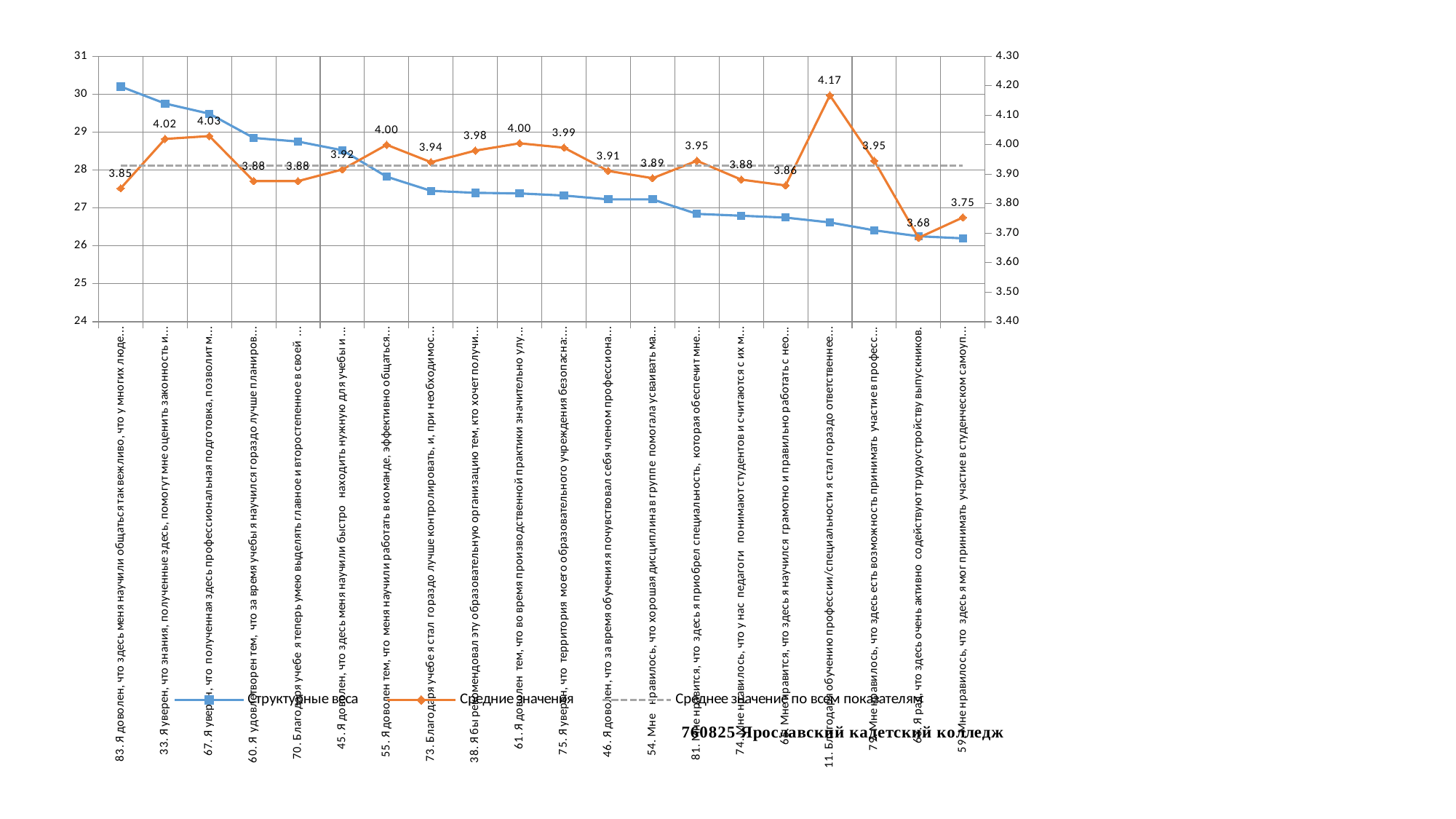
How many series does the legend list? 3 Does the 'Структурные веса' series rise or fall from left to right along the x axis? Falls What type of chart is shown on the slide? Line chart What is the 'Средние значения' value for statement 33 (Я уверен, что знания, полученные здесь, помогут мне оценить законность...)? 4.02 What is the 'Средние значения' value for statement 59 (Мне нравилось, что здесь я мог принимать участие в студенческом самоуп...)? 3.75 Which has a higher 'Средние значения' value: statement 67 or statement 60? Statement 67 What is the 'Средние значения' value for statement 83 (Я доволен, что здесь меня научили общаться так вежливо...)? 3.85 What is the lowest value shown for the 'Средние значения' series? 3.68 What is the difference between the highest (4.17) and lowest (3.68) values of the 'Средние значения' series? 0.49 How many categories (statements) are plotted along the x axis? 20 Which statement has the highest value in the 'Средние значения' series? 11. Благодаря обучению профессии/специальности я стал гораздо ответственнее What is the highest value shown for the 'Средние значения' series? 4.17